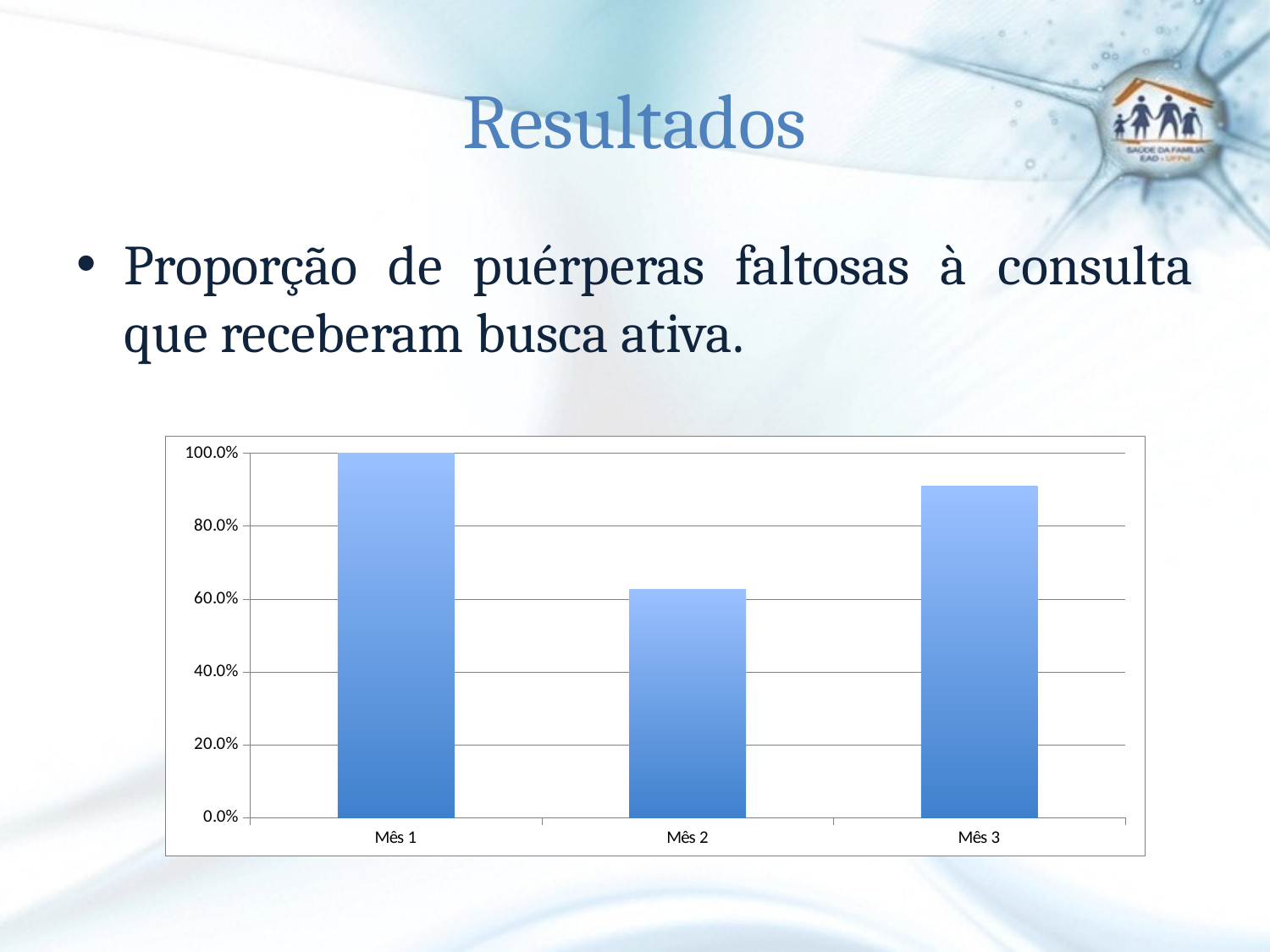
What is the highest value shown on the chart's y axis? 100.0% What is the value for Mês 1? 100.0% Which is larger, the value for Mês 2 or the value for Mês 3? Mês 3 Which is larger, the value for Mês 1 or the value for Mês 3? Mês 1 Is the value for Mês 2 greater or less than 80.0%? less How many categories are plotted on the x axis of the chart? 3 Is the value for Mês 3 greater or less than 80.0%? greater Which month has the highest value in the chart? Mês 1 Which month has the lowest value in the chart? Mês 2 From Mês 2 to Mês 3, does the value rise or fall? rise What kind of chart is shown on the slide? bar chart Is the value for Mês 2 greater or less than 60.0%? greater